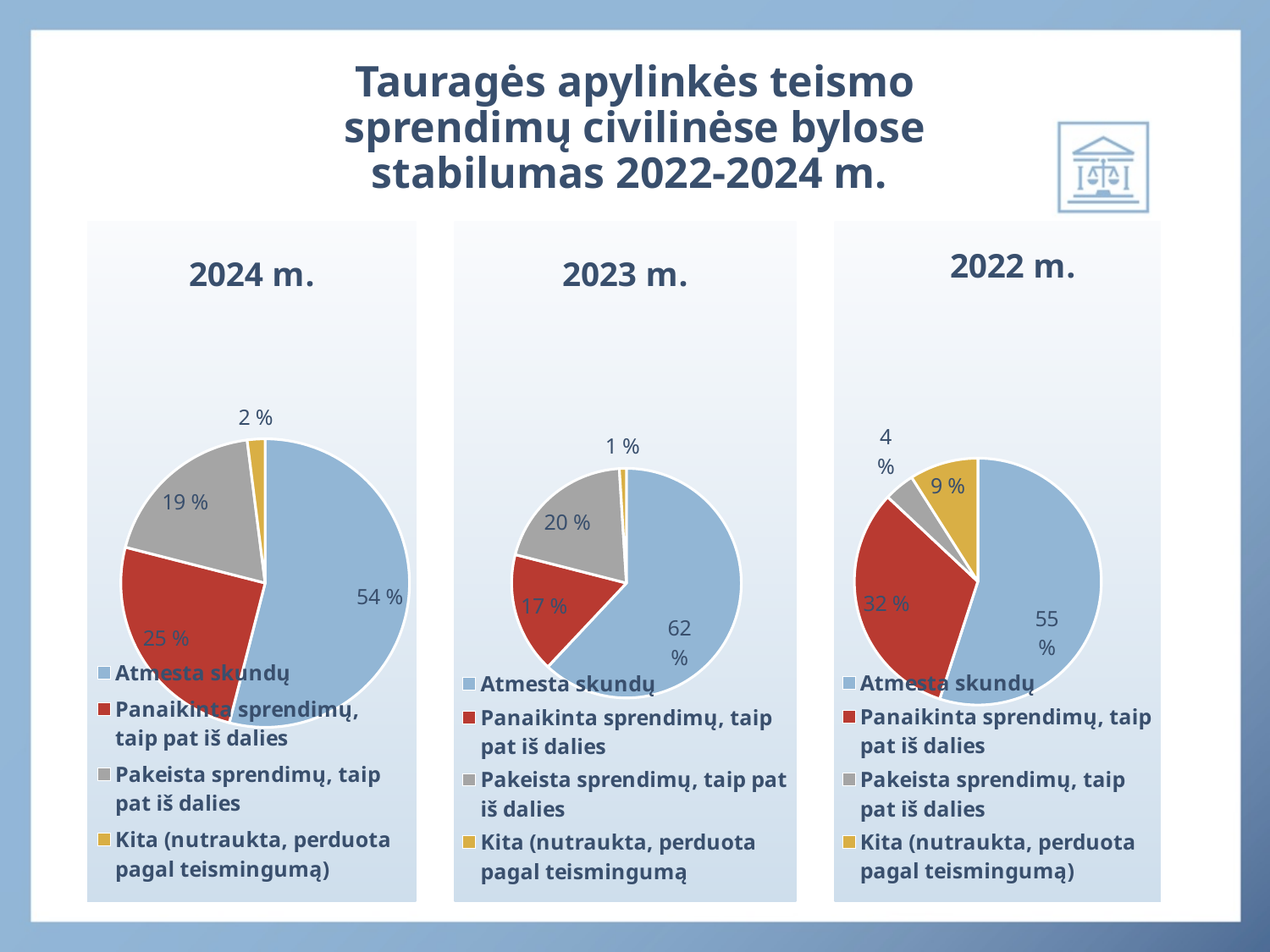
In the 2023 m. pie chart, what share is labelled for Pakeista sprendimų, taip pat iš dalies? 20 % How many slices does the 2022 m. pie chart have? 4 In the 2024 m. pie chart, which category has the smallest slice? Kita (nutraukta, perduota pagal teismingumą) In the 2023 m. pie chart, which category has the largest slice? Atmesta skundų In the 2022 m. pie chart, what share is labelled for Panaikinta sprendimų, taip pat iš dalies? 32 % In the 2023 m. pie chart, which is larger: the Panaikinta sprendimų slice or the Pakeista sprendimų slice? Pakeista sprendimų, taip pat iš dalies In the 2024 m. pie chart, what share is labelled for Atmesta skundų? 54 % In the 2022 m. pie chart, what share is labelled for Kita (nutraukta, perduota pagal teismingumą)? 9 % In the 2022 m. pie chart, which category has the smallest slice? Pakeista sprendimų, taip pat iš dalies What type of chart is used for the 2023 m. data? Pie chart In the 2024 m. pie chart, what is the difference between the Panaikinta sprendimų share and the Pakeista sprendimų share? 6 % How many pie charts are shown on the slide? 3